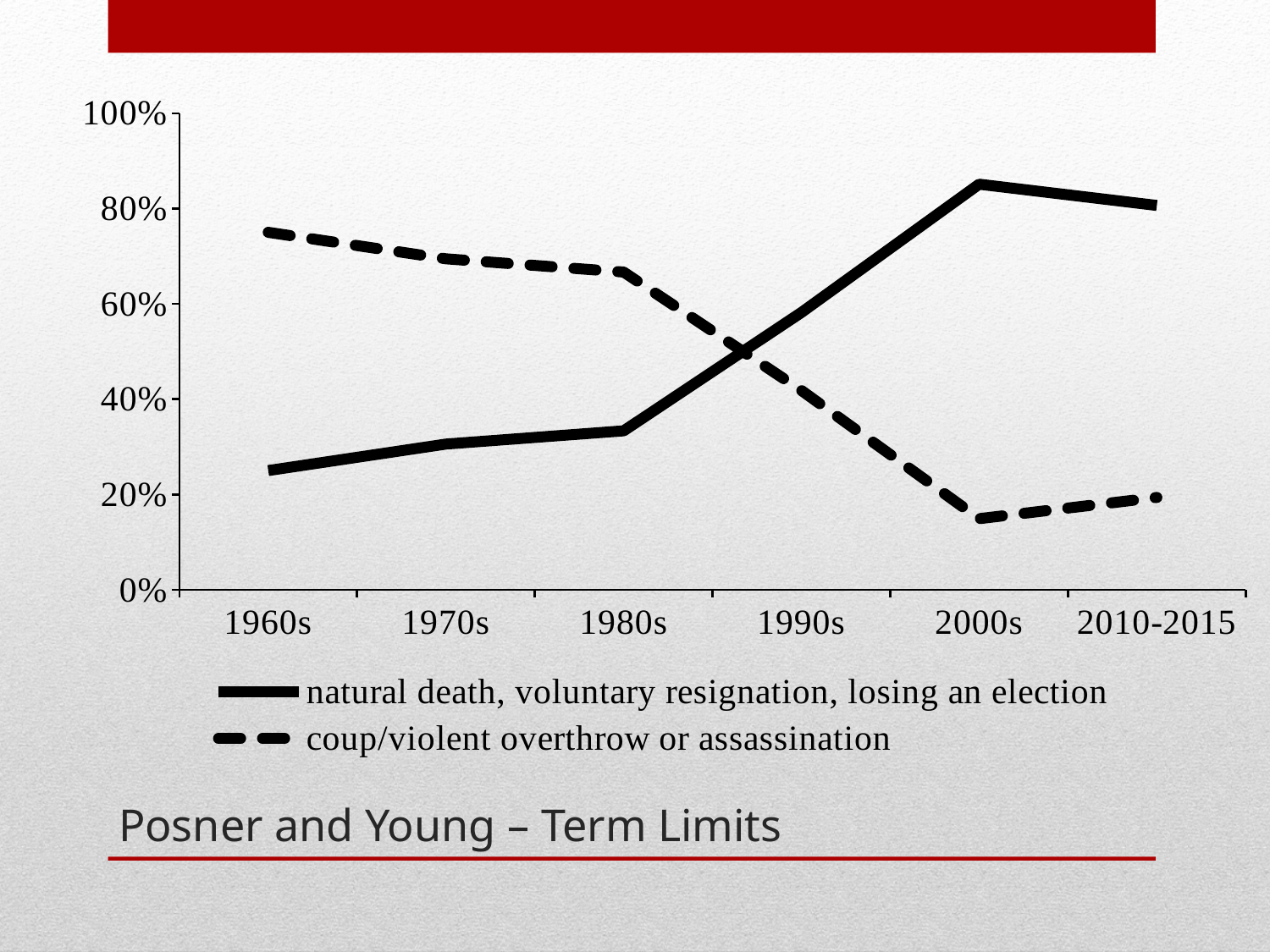
Is the value for 'coup/violent overthrow or assassination' in the 1960s greater or less than 60%? greater In which period is the 'natural death, voluntary resignation, losing an election' line at its lowest? 1960s Does the 'coup/violent overthrow or assassination' line generally rise or fall from the 1960s to 2010-2015? fall What kind of chart is shown on the slide? line chart Is the value for 'natural death, voluntary resignation, losing an election' in the 1960s greater or less than 40%? less How many time periods are shown along the x axis? 6 In which period is the 'coup/violent overthrow or assassination' line at its highest? 1960s In the 1990s, which series has the higher value: 'natural death, voluntary resignation, losing an election' or 'coup/violent overthrow or assassination'? natural death, voluntary resignation, losing an election In which period is the 'natural death, voluntary resignation, losing an election' line at its highest? 2000s How many series does the legend list? 2 In which period is the 'coup/violent overthrow or assassination' line at its lowest? 2000s Does the 'natural death, voluntary resignation, losing an election' line generally rise or fall from the 1960s to 2010-2015? rise